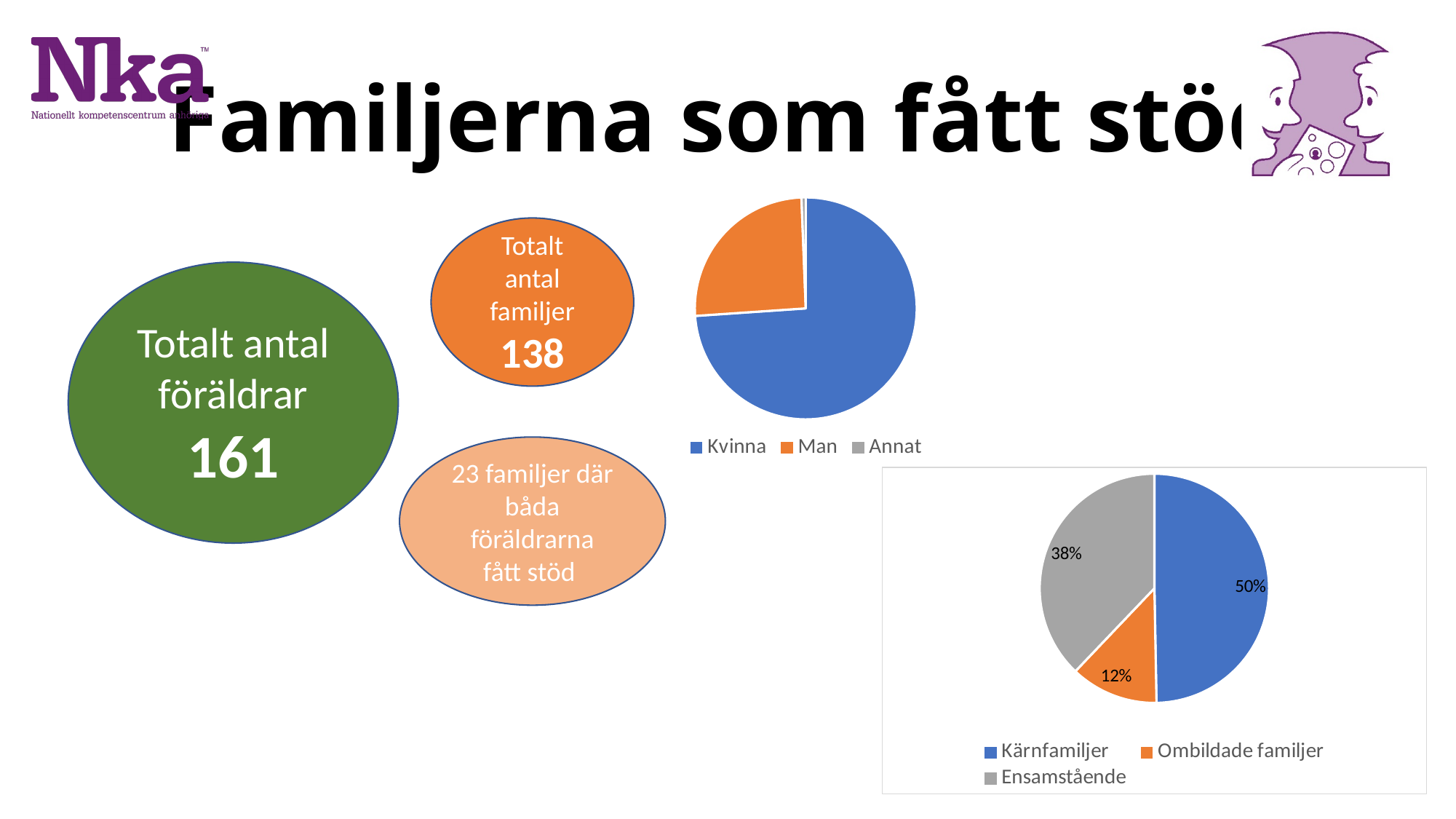
In the upper pie chart (Kvinna, Man, Annat), which category has the smallest slice? Annat What kind of chart is the upper chart on the slide (legend Kvinna, Man, Annat)? pie chart In the lower pie chart, what share is shown for Ensamstående? 38% How many entries does the legend of the upper pie chart (Kvinna, Man, Annat) list? 3 In the lower pie chart, what is the difference in percentage points between Ensamstående and Ombildade familjer? 26 In the upper pie chart (Kvinna, Man, Annat), which slice is larger, Kvinna or Man? Kvinna In the lower pie chart, which category has the smallest share? Ombildade familjer In the upper pie chart (Kvinna, Man, Annat), which category has the largest slice? Kvinna In the lower pie chart, what share is shown for Kärnfamiljer? 50% What kind of chart is the lower chart on the slide (legend Kärnfamiljer, Ombildade familjer, Ensamstående)? pie chart In the lower pie chart, which category has the largest share? Kärnfamiljer In the lower pie chart, what share is shown for Ombildade familjer? 12%